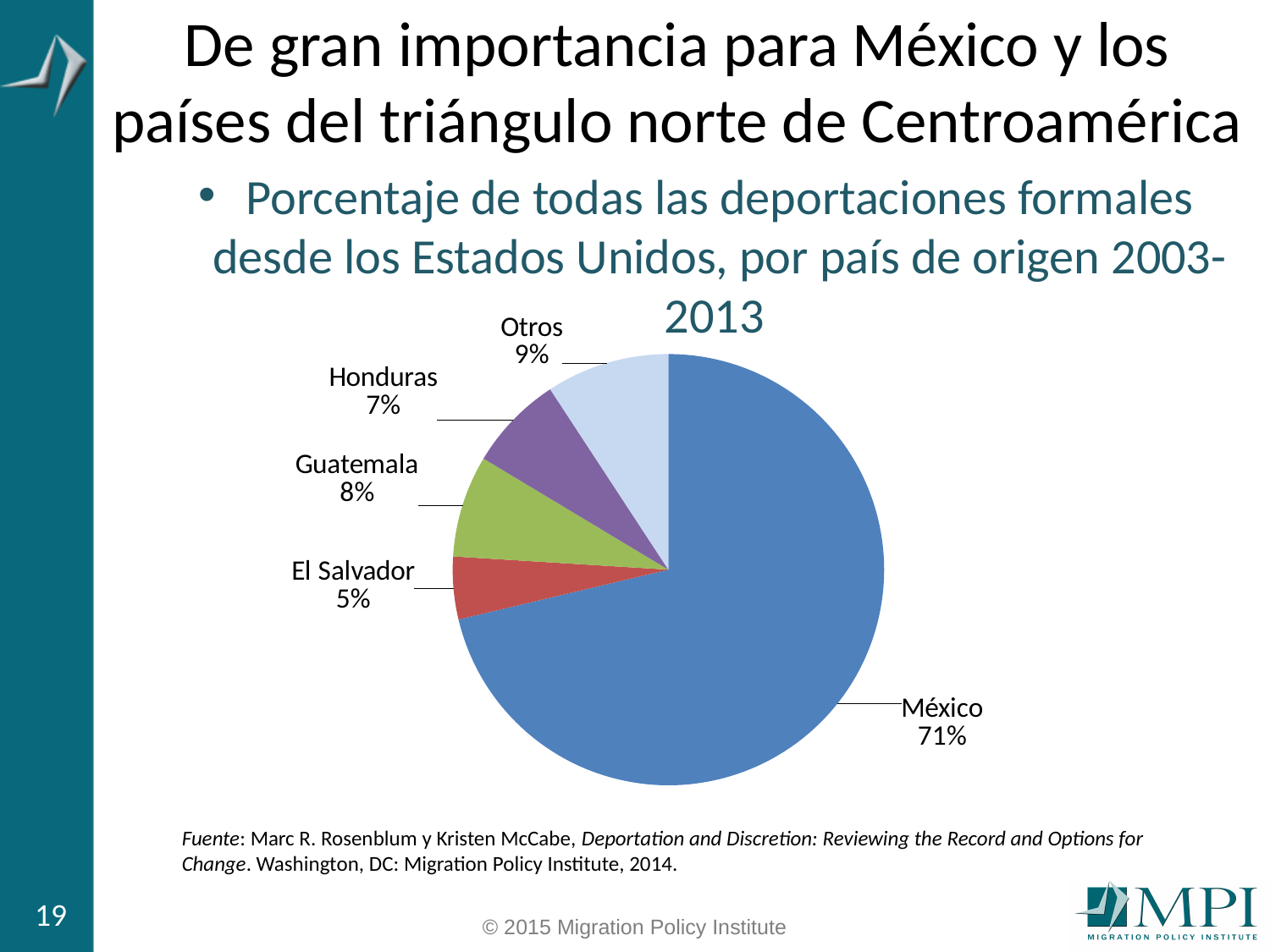
What colour is the slice for México? Blue What kind of chart is shown on the slide? Pie chart Which category has the largest slice of the pie? México What is the value shown for Guatemala? 8% What is the value shown for Honduras? 7% How many slices does the pie chart have? 5 What is the value shown for El Salvador? 5% Which category has the smallest slice of the pie? El Salvador What share of the pie does México account for? 71% What is the value shown for Otros? 9% Which is larger, the slice for Guatemala or the slice for Honduras? Guatemala What is the difference in percentage points between México and Otros? 62